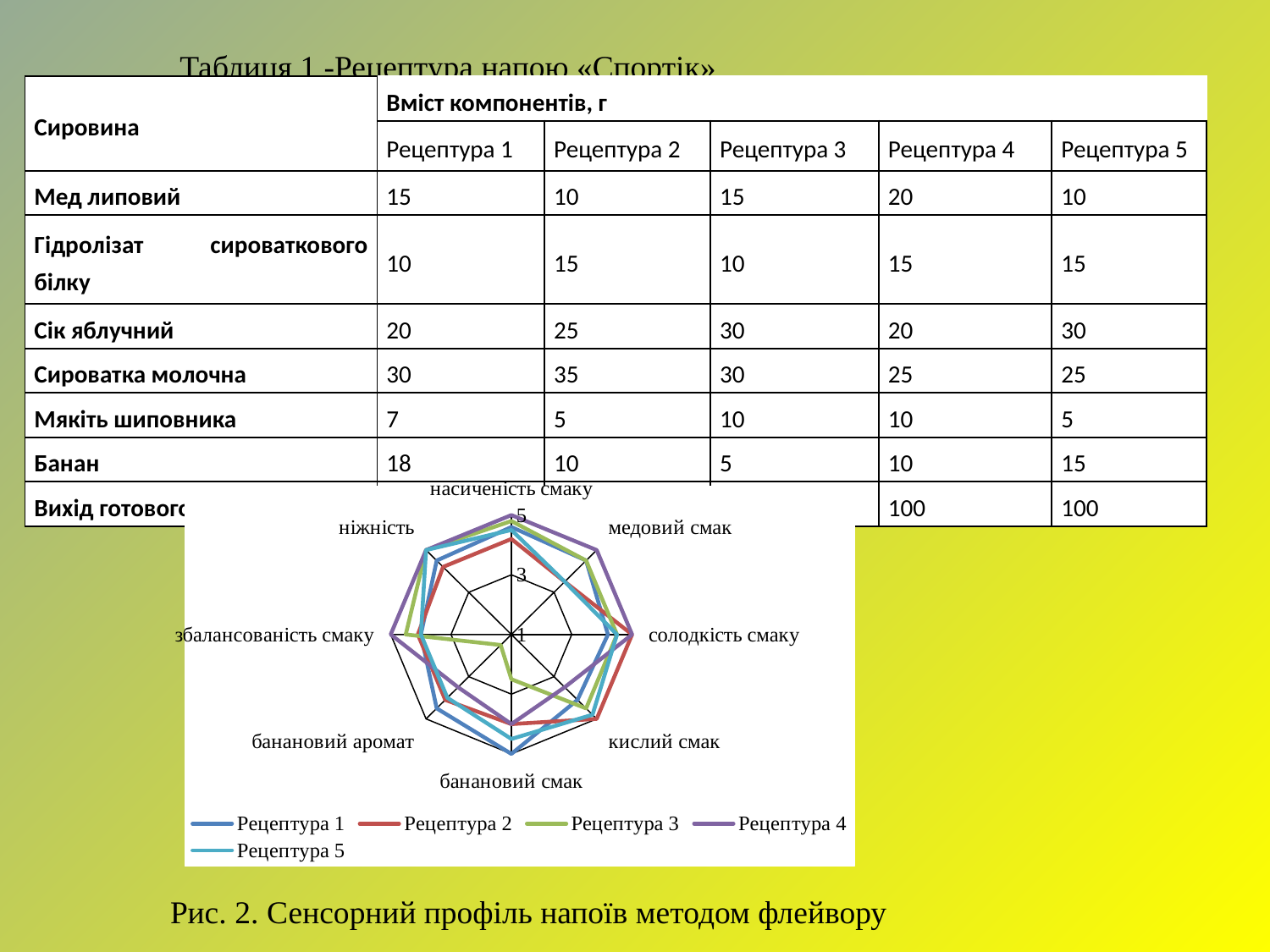
In the radar chart, which has the larger value for банановий смак: Рецептура 4 or Рецептура 3? Рецептура 4 In the radar chart, is the value of Рецептура 4 for медовий смак greater or less than 3? greater In the radar chart, is the value of Рецептура 3 for банановий смак greater or less than 3? less In the radar chart, which recipe has the lowest value for банановий смак? Рецептура 3 What is the caption of the radar chart on the slide? Рис. 2. Сенсорний профіль напоїв методом флейвору How many series does the legend of the radar chart list? 5 In the radar chart, is the value of Рецептура 4 for збалансованість смаку greater or less than 3? greater How many sensory attributes (axes) does the radar chart have? 8 What kind of chart is shown on the slide below the table? radar chart What is the highest tick value shown on the radar chart's axis? 5